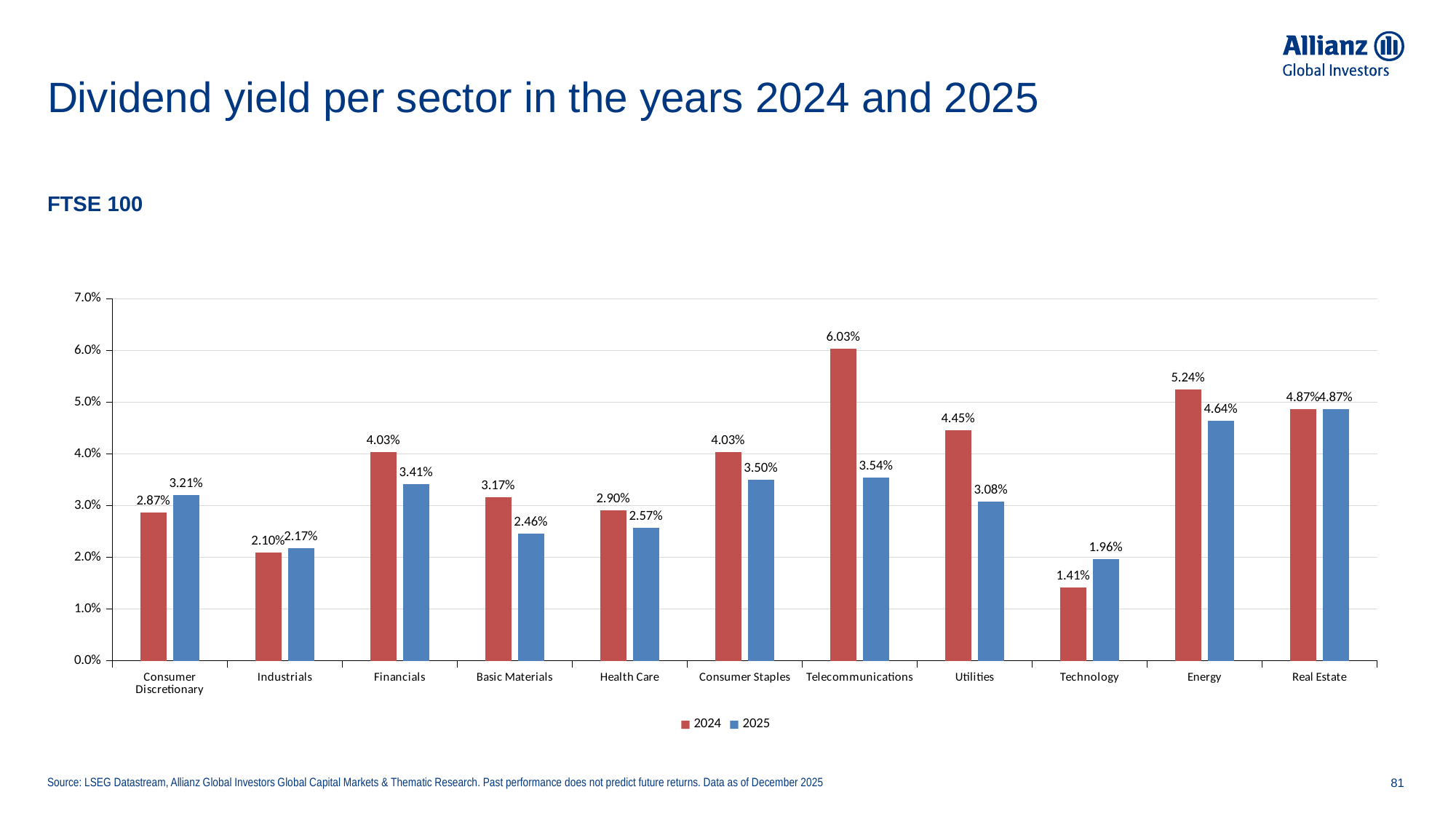
How many series does the legend list? 2 Which is larger for Consumer Discretionary, the 2024 or the 2025 dividend yield? 2025 How many sectors are shown on the x axis? 11 Which sector has the highest 2024 dividend yield? Telecommunications Is the 2024 dividend yield for Energy greater or less than 5.0%? greater Which index does the chart cover, according to the subtitle? FTSE 100 Which sector has the lowest 2025 dividend yield? Technology What kind of chart is shown on the slide? Bar chart What is the 2025 dividend yield for Energy? 4.64% What is the 2024 dividend yield for Telecommunications? 6.03% What is the difference between the 2024 and 2025 dividend yields for Telecommunications? 2.49% What is the 2025 dividend yield for Technology? 1.96%